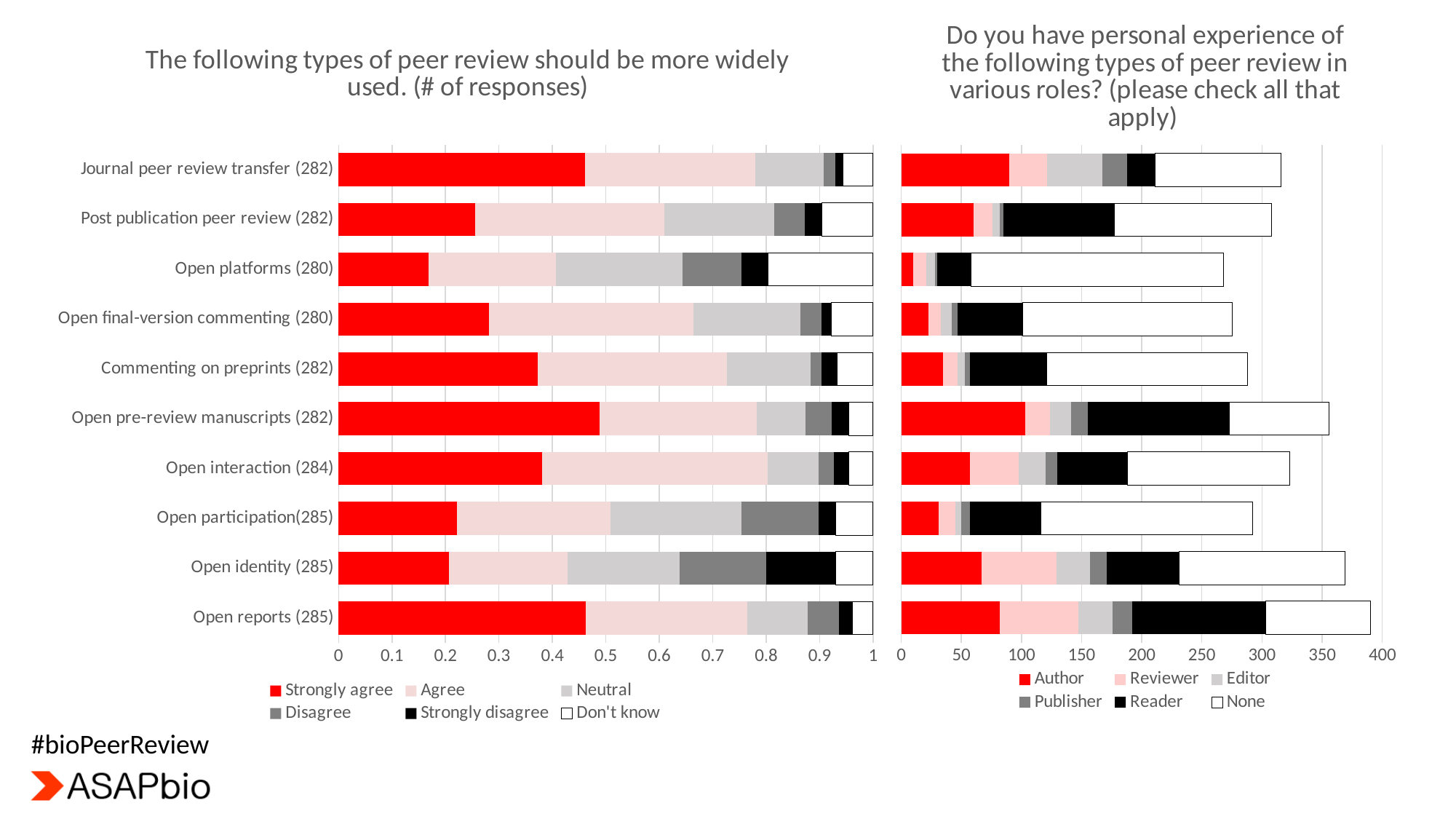
On the right chart, which category has the smallest 'Author' value? Open platforms (280) On the left chart, is the 'Strongly agree' share for 'Open platforms (280)' greater or less than 0.2? less How many series does the legend of the right chart ('Do you have personal experience...') list? 6 On the left chart, which is larger: the 'Strongly agree' share for 'Open platforms (280)' or for 'Journal peer review transfer (282)'? Journal peer review transfer (282) What kind of chart is the left chart, 'The following types of peer review should be more widely used'? Stacked bar chart On the right chart, which is larger: the 'Reader' value for 'Post publication peer review (282)' or for 'Open platforms (280)'? Post publication peer review (282) On the right chart, is the 'Author' value for 'Journal peer review transfer (282)' greater or less than 50? greater Which series is shown in black on the right chart? Reader On the left chart, which category has the largest 'Strongly disagree' share? Open identity (285) How many categories (types of peer review) are shown on the left chart? 10 On the right chart, is the total length of the bar for 'Open reports (285)' greater or less than 350? greater